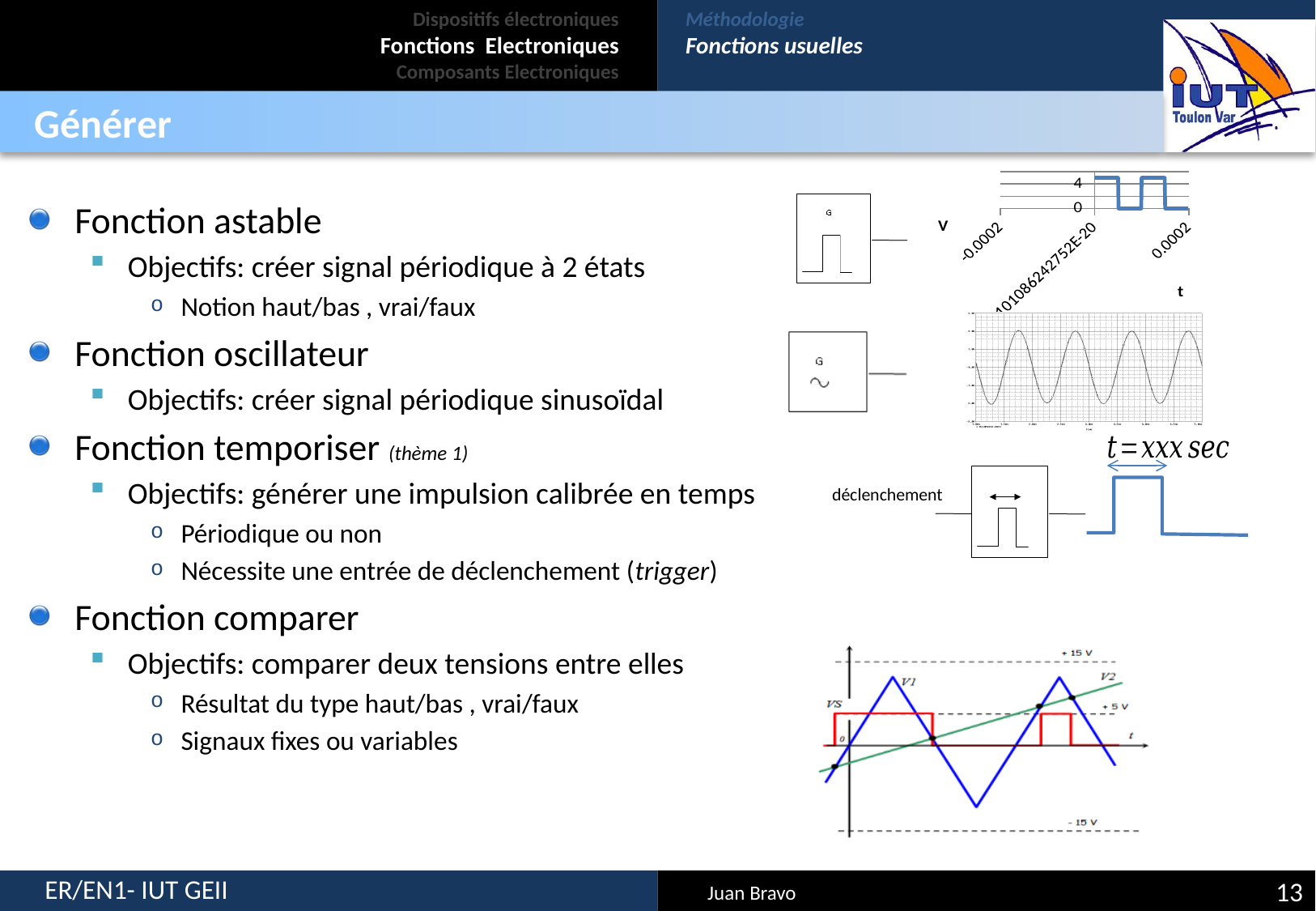
In the top-right chart (V versus t), what is the lowest value shown on the vertical axis? 0 In the top-right chart (V versus t), what is the highest value shown on the vertical axis? 4 What type of chart is the chart at the top right of the slide (with axes V and t)? line chart What label is shown on the vertical axis of the top-right chart? V In the top-right chart (V versus t), what is the rightmost tick value on the horizontal axis? 0.0002 In the comparator diagram at the bottom right, what voltage level is marked by the lower dashed line? - 15 V In the comparator diagram at the bottom right, what voltage level is marked by the dashed line just above the red output signal? + 5 V What label is shown on the horizontal axis of the top-right chart? t In the comparator diagram at the bottom right, which signal is drawn as a blue triangular wave? V1 In the top-right chart (V versus t), what is the leftmost tick value on the horizontal axis? -0.0002 In the comparator diagram at the bottom right, what voltage level is marked by the upper dashed line? + 15 V